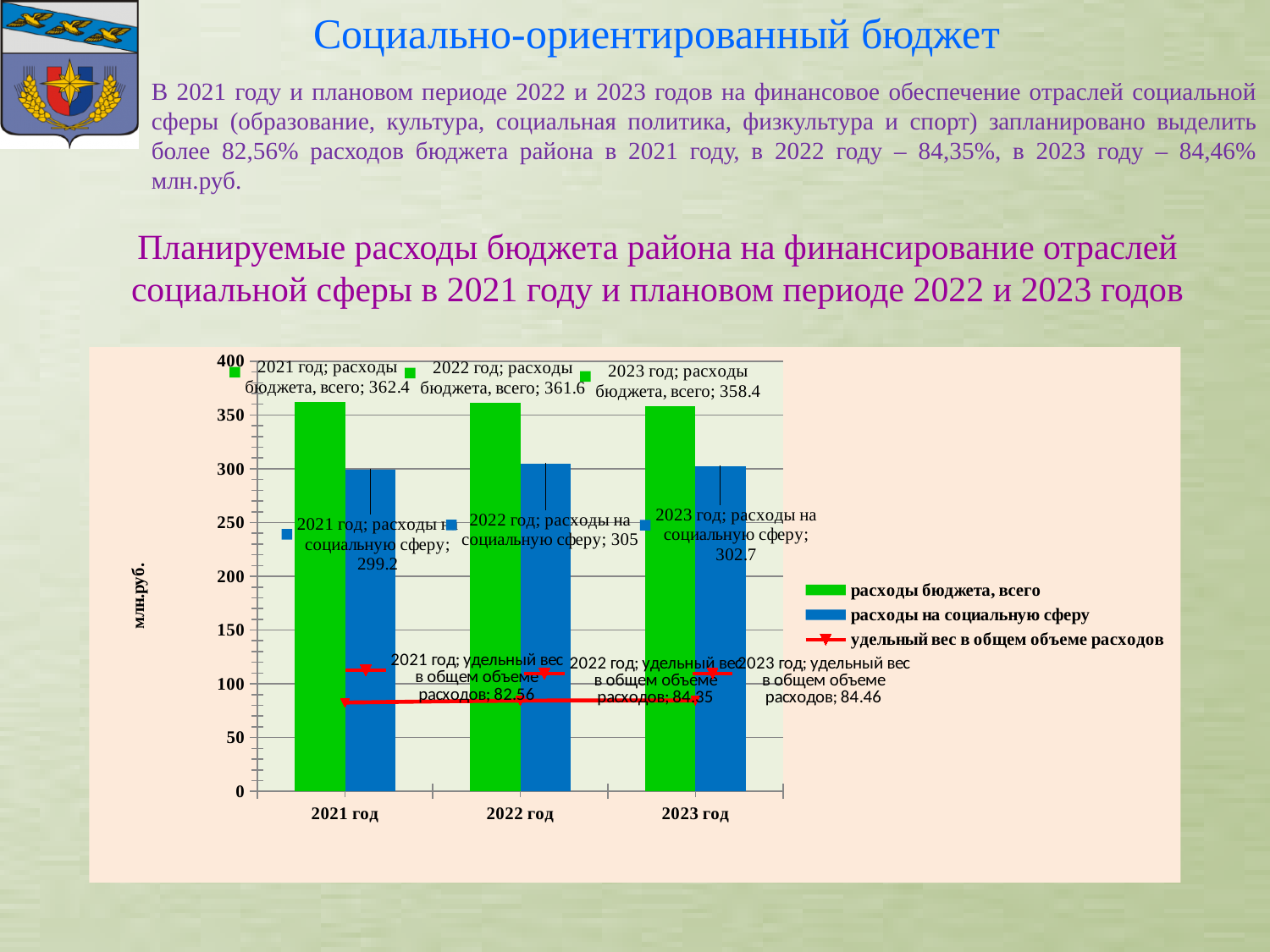
How many years (categories) are shown on the x axis? 3 Does 'расходы бюджета, всего' rise or fall from 2021 год to 2023 год? Fall What is the value of 'удельный вес в общем объеме расходов' for 2023 год? 84.46 Which is larger: 'расходы на социальную сферу' in 2022 год or in 2023 год? 2022 год Which year has the lowest value for 'расходы на социальную сферу'? 2021 год What is the label of the vertical axis? млн.руб. What is the difference between 'расходы бюджета, всего' and 'расходы на социальную сферу' in 2023 год? 55.7 What is the value of 'расходы бюджета, всего' for 2021 год? 362.4 Which year has the highest value for 'расходы бюджета, всего'? 2021 год How many series does the legend list? 3 What kind of chart is shown on the slide? Bar chart with a line What is the value of 'расходы на социальную сферу' for 2022 год? 305